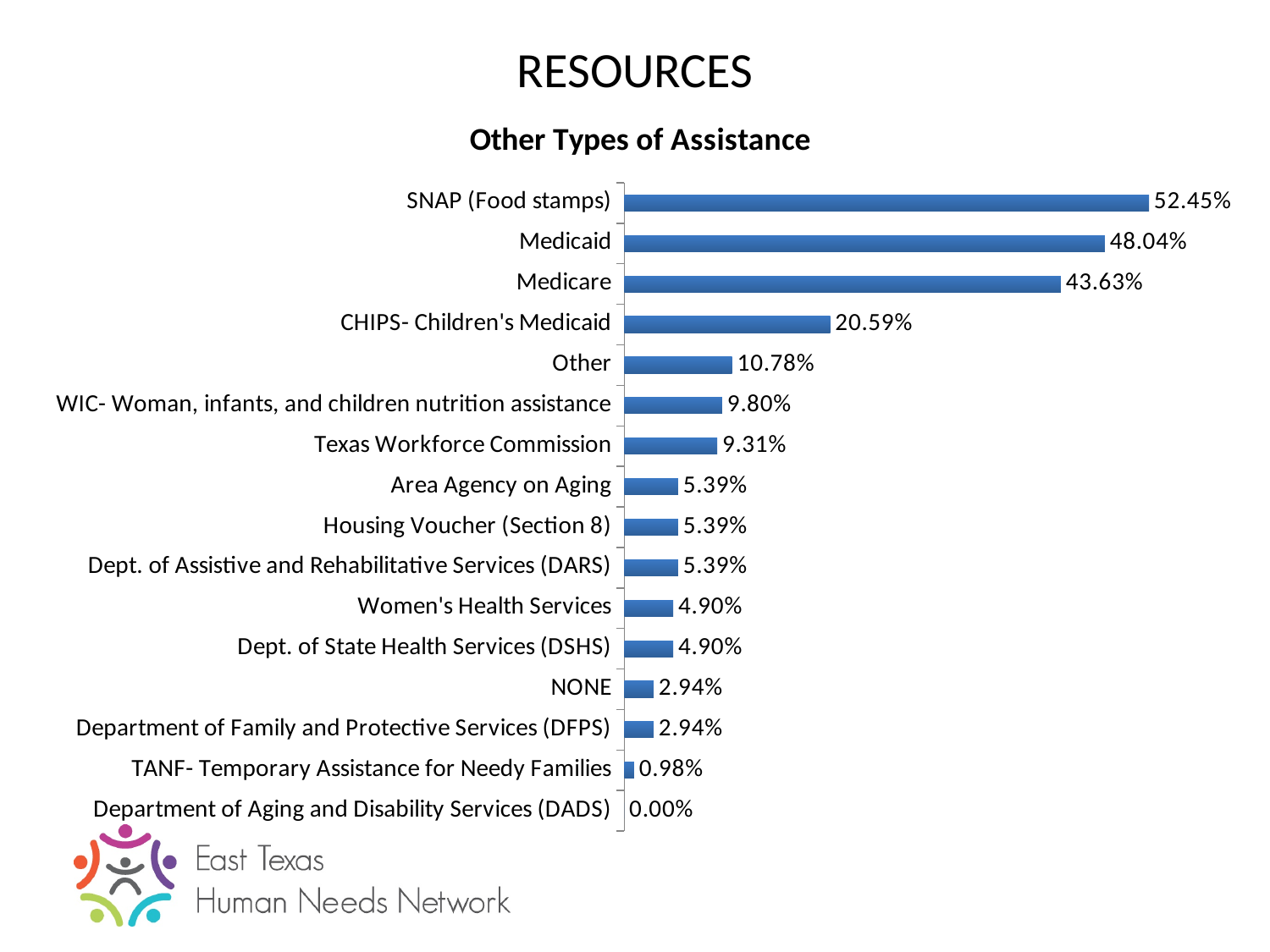
What kind of chart is shown on the slide? Bar chart Which category has the highest value? SNAP (Food stamps) What is the value for CHIPS- Children's Medicaid? 20.59% What is the difference between the values for SNAP (Food stamps) and NONE? 49.51% What is the difference between the values for Medicaid and Medicare? 4.41% Which category has the lowest value? Department of Aging and Disability Services (DADS) How many categories are shown in the chart? 16 Which is larger, the value for Other or the value for WIC- Woman, infants, and children nutrition assistance? Other What is the value for Texas Workforce Commission? 9.31% What is the title of the chart? Other Types of Assistance What is the value for SNAP (Food stamps)? 52.45% What is the value for TANF- Temporary Assistance for Needy Families? 0.98%